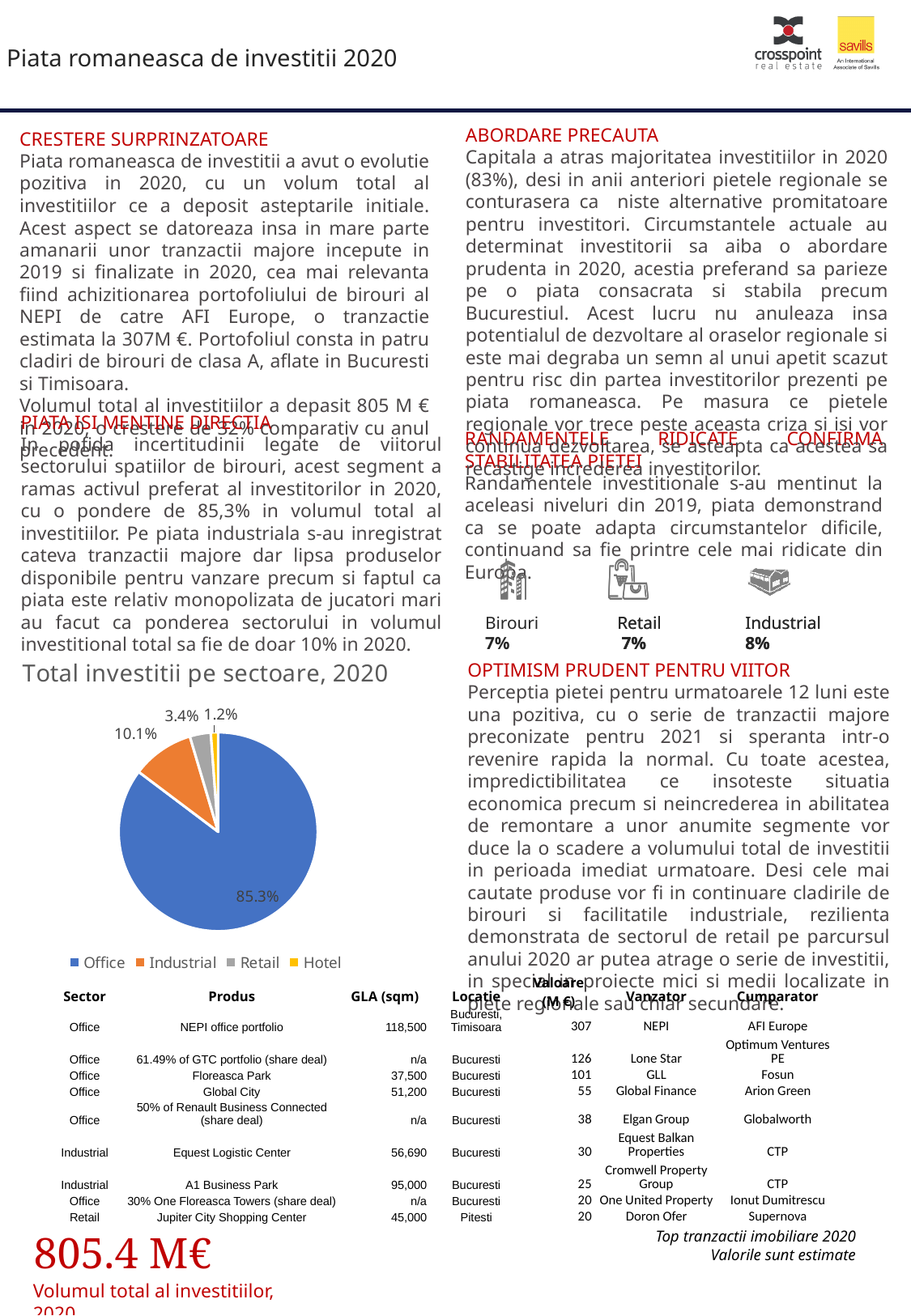
Which sector has the smallest slice in the pie chart 'Total investitii pe sectoare, 2020'? Hotel In the pie chart 'Total investitii pe sectoare, 2020', what share does Hotel have? 1.2% In the pie chart 'Total investitii pe sectoare, 2020', what share does Industrial have? 10.1% How many sectors are shown in the pie chart 'Total investitii pe sectoare, 2020'? 4 What type of chart is shown under the title 'Total investitii pe sectoare, 2020'? pie chart In the pie chart 'Total investitii pe sectoare, 2020', what is the difference between the Office share and the Industrial share? 75.2 percentage points How many entries does the legend of the pie chart 'Total investitii pe sectoare, 2020' list? 4 In the pie chart 'Total investitii pe sectoare, 2020', which colour represents the Industrial sector? orange In the pie chart 'Total investitii pe sectoare, 2020', what share does Office have? 85.3% In the pie chart 'Total investitii pe sectoare, 2020', which is larger: the Retail share or the Hotel share? Retail In the pie chart 'Total investitii pe sectoare, 2020', what share does Retail have? 3.4% Which sector has the largest slice in the pie chart 'Total investitii pe sectoare, 2020'? Office